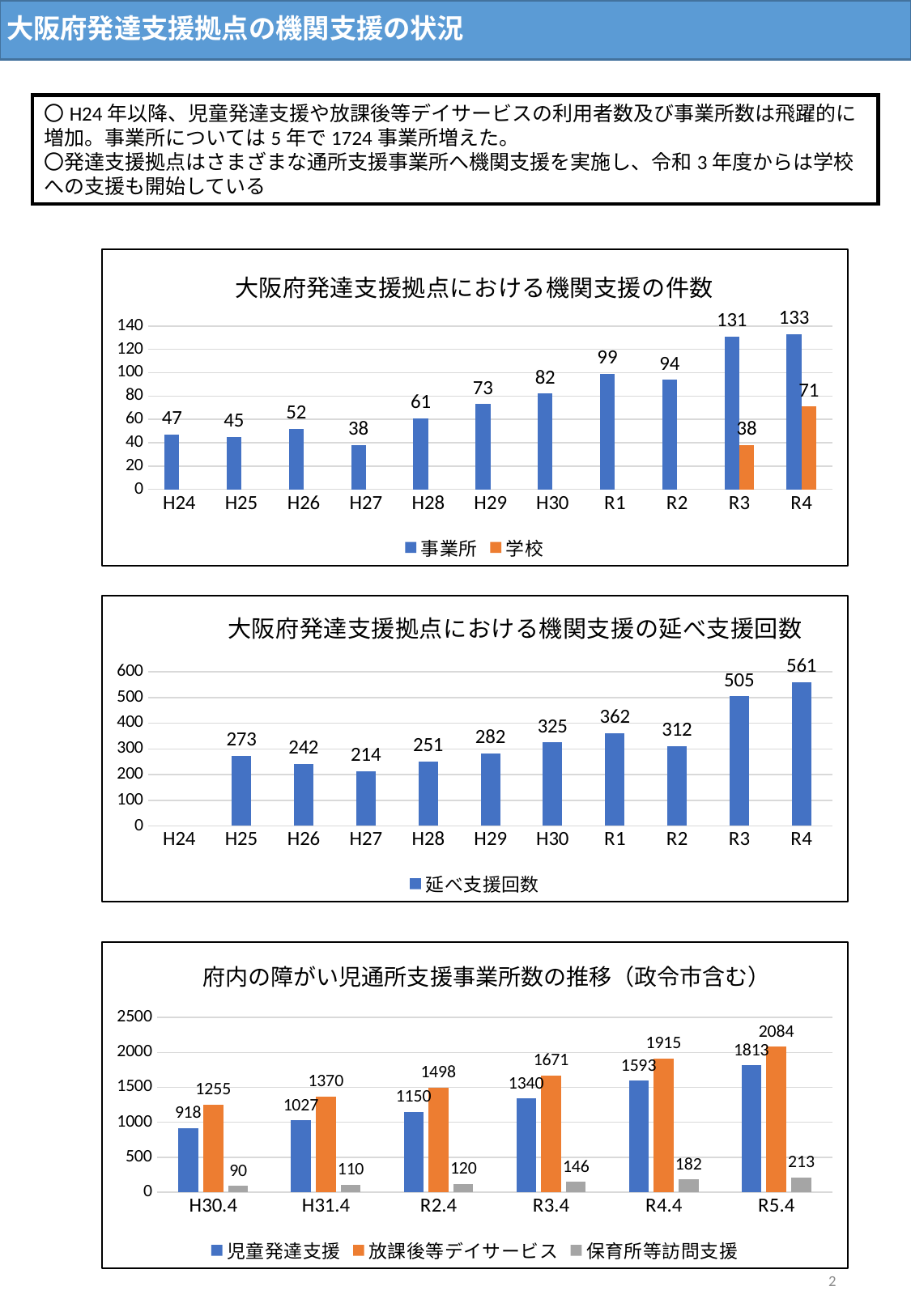
In the middle chart (大阪府発達支援拠点における機関支援の延べ支援回数), which year has the highest value? R4 In the top chart (大阪府発達支援拠点における機関支援の件数), what is the difference between the 事業所 values for R4 and H24? 86 In the middle chart (大阪府発達支援拠点における機関支援の延べ支援回数), which is larger, the value for R1 or the value for R2? R1 In the top chart (大阪府発達支援拠点における機関支援の件数), how many series does the legend list? 2 In the top chart (大阪府発達支援拠点における機関支援の件数), what is the value for 事業所 in R3? 131 In the bottom chart (府内の障がい児通所支援事業所数の推移), how many categories are shown on the x axis? 6 In the top chart (大阪府発達支援拠点における機関支援の件数), which year has the lowest 事業所 value? H27 In the bottom chart (府内の障がい児通所支援事業所数の推移), what is the difference between 放課後等デイサービス and 児童発達支援 at H30.4? 337 In the bottom chart (府内の障がい児通所支援事業所数の推移), what is the value for 放課後等デイサービス at R5.4? 2084 In the top chart (大阪府発達支援拠点における機関支援の件数), what is the value for 学校 in R4? 71 In the middle chart (大阪府発達支援拠点における機関支援の延べ支援回数), what is the value for R3? 505 What kind of chart is the middle chart (大阪府発達支援拠点における機関支援の延べ支援回数)? Bar chart